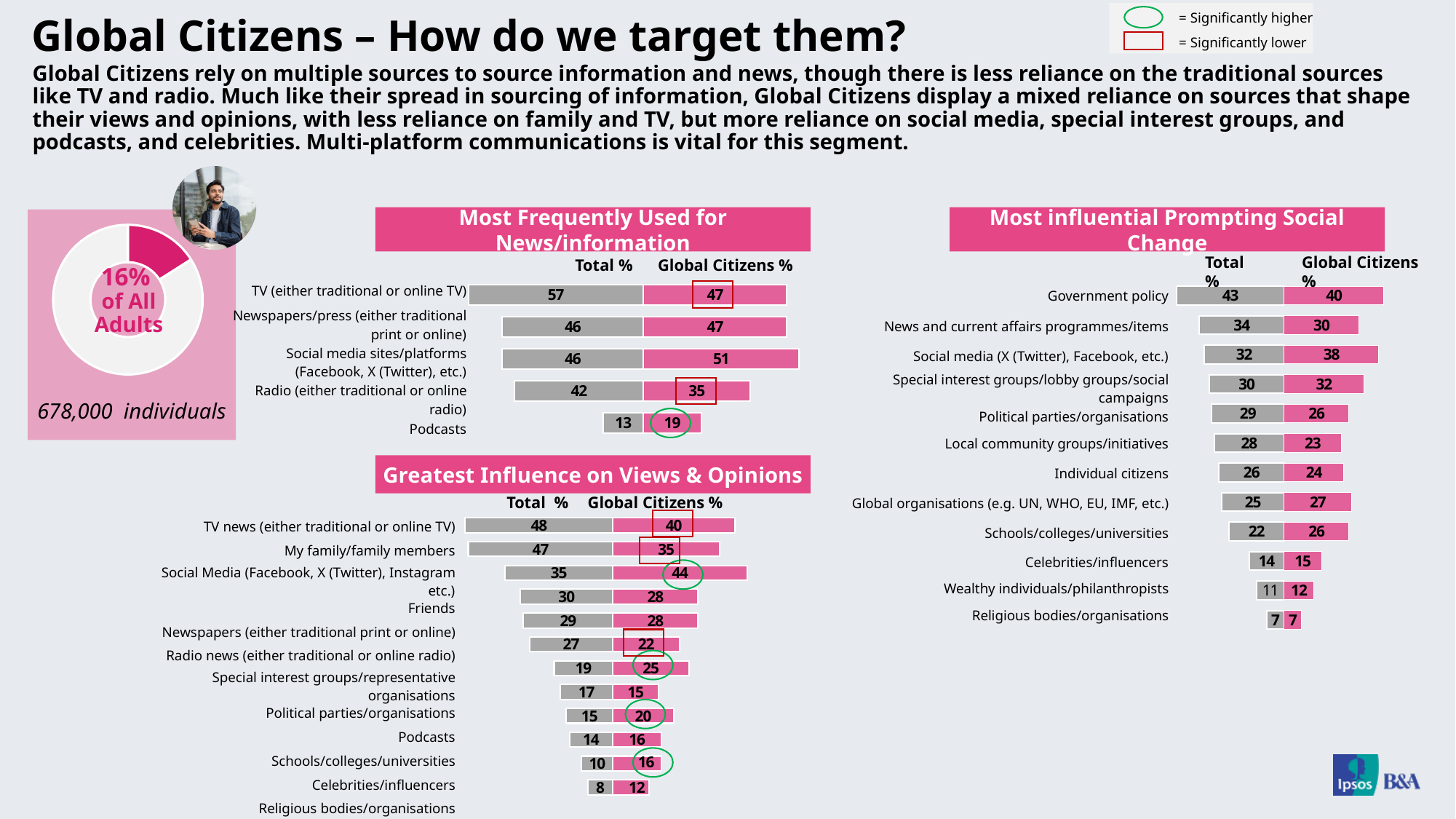
In the 'Most Frequently Used for News/information' chart, what is the difference between the Total % and Global Citizens % for Radio? 7 In the 'Most Frequently Used for News/information' chart, which category has the highest Global Citizens %? Social media sites/platforms What kind of chart is used for 'Most influential Prompting Social Change'? Bar chart In the 'Most influential Prompting Social Change' chart, which category has the lowest Total %? Religious bodies/organisations In the 'Most Frequently Used for News/information' chart, what is the Total % for TV (either traditional or online TV)? 57 In the 'Most Frequently Used for News/information' chart, how many categories are shown? 5 In the 'Most influential Prompting Social Change' chart, what is the difference between the Total % and Global Citizens % for Local community groups/initiatives? 5 In the 'Greatest Influence on Views & Opinions' chart, what is the Total % for My family/family members? 47 In the 'Most influential Prompting Social Change' chart, what is the Global Citizens % for Social media (X (Twitter), Facebook, etc.)? 38 In the 'Greatest Influence on Views & Opinions' chart, which is larger for Social Media: the Total % or the Global Citizens %? Global Citizens % In the 'Most Frequently Used for News/information' chart, what is the Global Citizens % for Podcasts? 19 In the 'Greatest Influence on Views & Opinions' chart, what is the Global Citizens % for TV news? 40